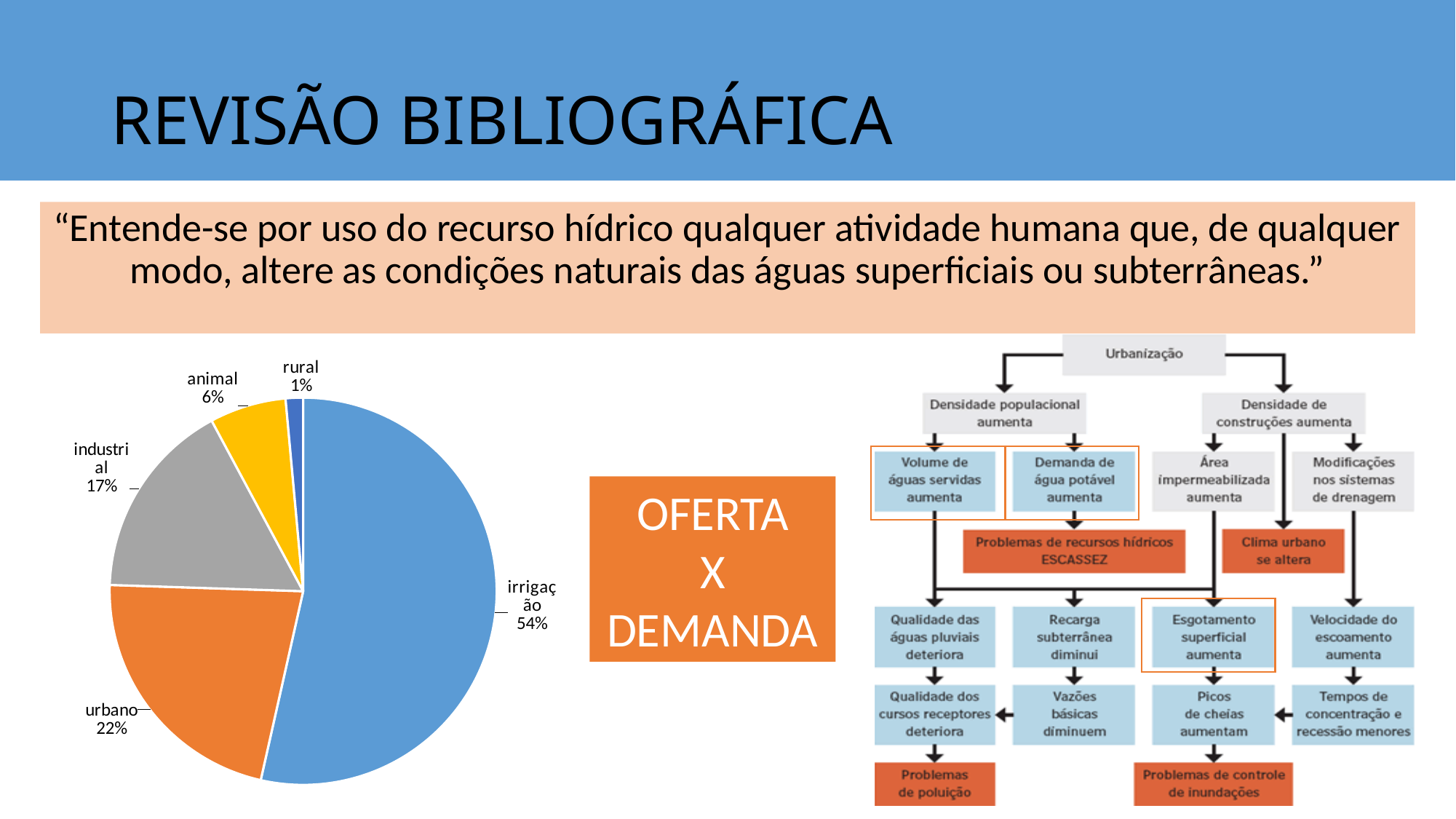
In the pie chart, what colour is the irrigação slice? blue How many categories does the pie chart show? 5 Which category has the largest slice in the pie chart? irrigação In the pie chart, what share does urbano have? 22% In the pie chart, what share does rural have? 1% In the pie chart, which is larger: the share of industrial or the share of animal? industrial Which category has the smallest slice in the pie chart? rural In the pie chart, what is the difference between the shares of irrigação and urbano? 32% In the pie chart, what share does irrigação have? 54% What kind of chart is shown on the left of the slide? pie chart In the pie chart, what share does animal have? 6% In the pie chart, what share does industrial have? 17%